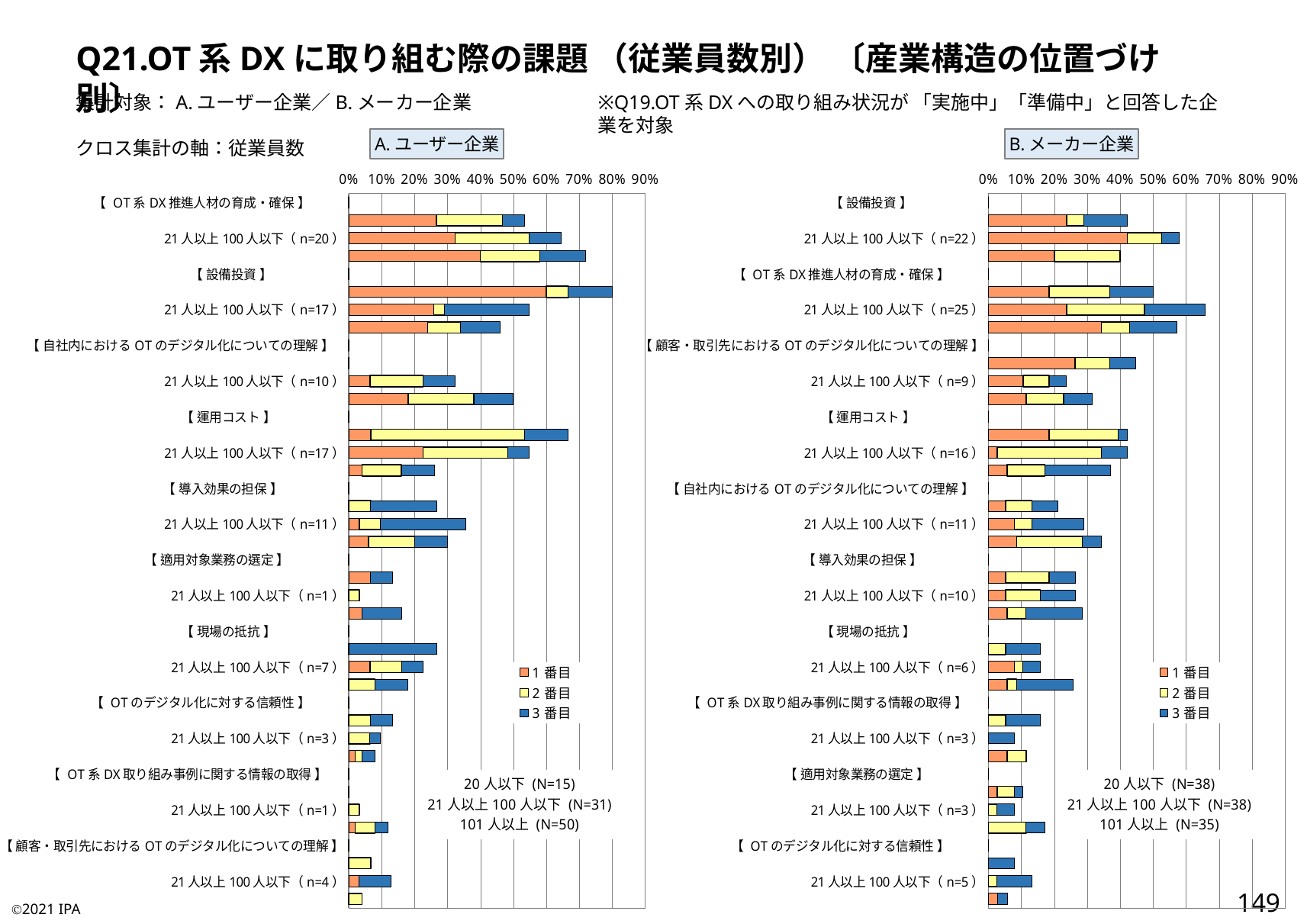
In the A. ユーザー企業 chart, which challenge group contains the longest stacked bar? 設備投資 In the A. ユーザー企業 chart, is the total value of the longest bar in the 【設備投資】 group greater or less than 70%? greater How many series does the legend list in the B. メーカー企業 chart? 3 In the A. ユーザー企業 chart, is the total value of the 21人以上100人以下 (n=20) bar under 【OT系DX推進人材の育成・確保】 greater or less than 50%? greater What kind of chart is used for A. ユーザー企業? Stacked bar chart What are the legend entries in the A. ユーザー企業 chart? 1番目, 2番目, 3番目 In the B. メーカー企業 chart, is the total value of the 21人以上100人以下 (n=25) bar under 【OT系DX推進人材の育成・確保】 greater or less than 60%? greater In the A. ユーザー企業 chart, what is the N for 101人以上? 50 In the B. メーカー企業 chart, which challenge group contains the longest stacked bar? OT系DX推進人材の育成・確保 In the A. ユーザー企業 chart, which is longer: the 21人以上100人以下 (n=7) bar under 【現場の抵抗】 or the 21人以上100人以下 (n=1) bar under 【適用対象業務の選定】? 21人以上100人以下 (n=7) under 【現場の抵抗】